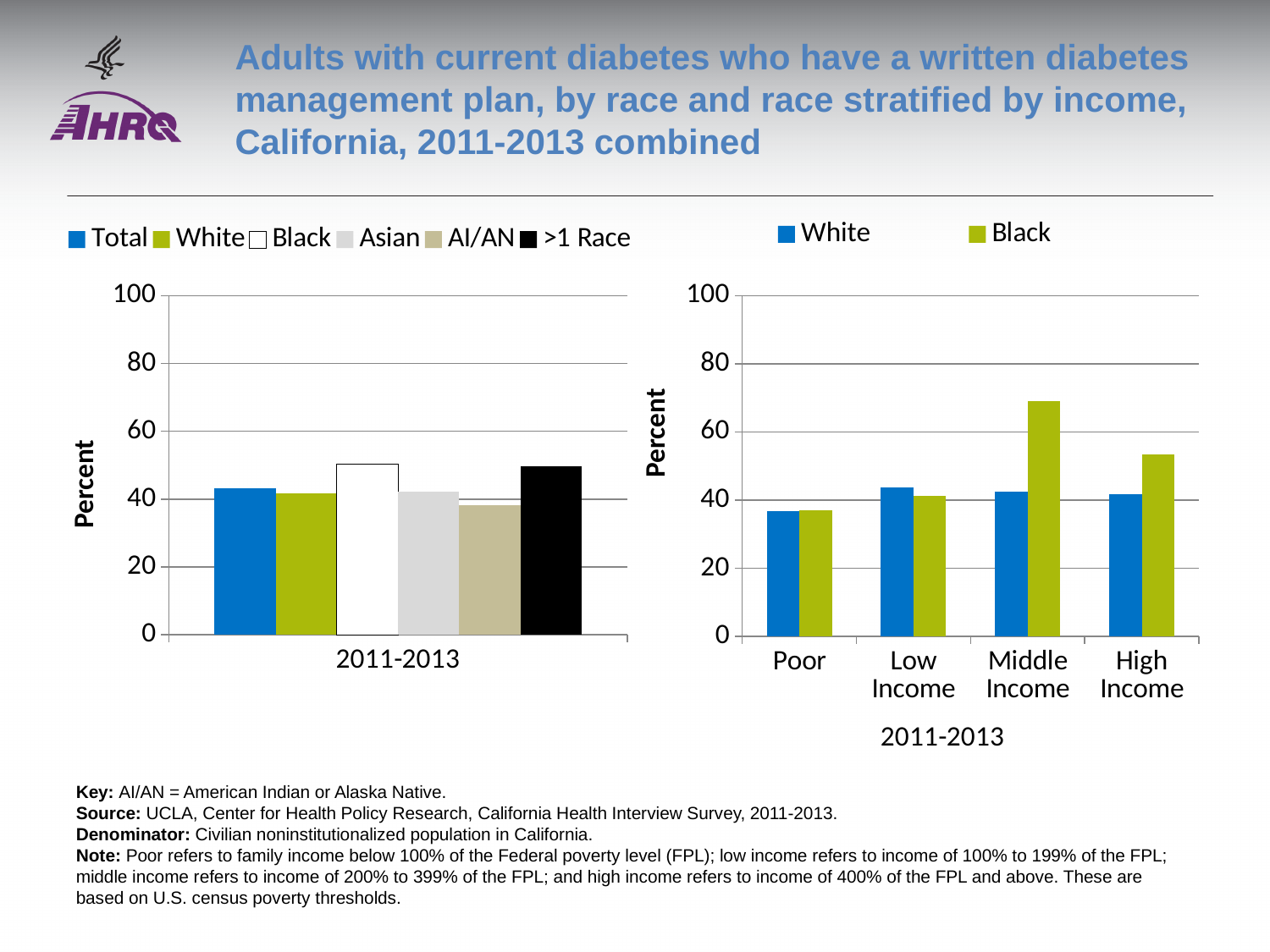
What is the label on the y axis of the left-hand chart? Percent In the right-hand chart, for the Middle Income group, which is larger: the value for White or for Black? Black In the right-hand chart, is the value for White adults in the Poor group greater or less than 40? less In the left-hand chart, is the value for Black greater or less than 40? greater In the right-hand chart, is the value for Black adults in the Middle Income group greater or less than 60? greater In the right-hand chart, which income group has the highest value for Black adults? Middle Income How many income categories are shown on the x axis of the right-hand chart? 4 In the right-hand chart, for the High Income group, which is larger: the value for White or for Black? Black What kind of chart is the right-hand chart (White and Black by income)? bar chart How many series does the legend of the right-hand chart list? 2 How many series does the legend of the left-hand chart list? 6